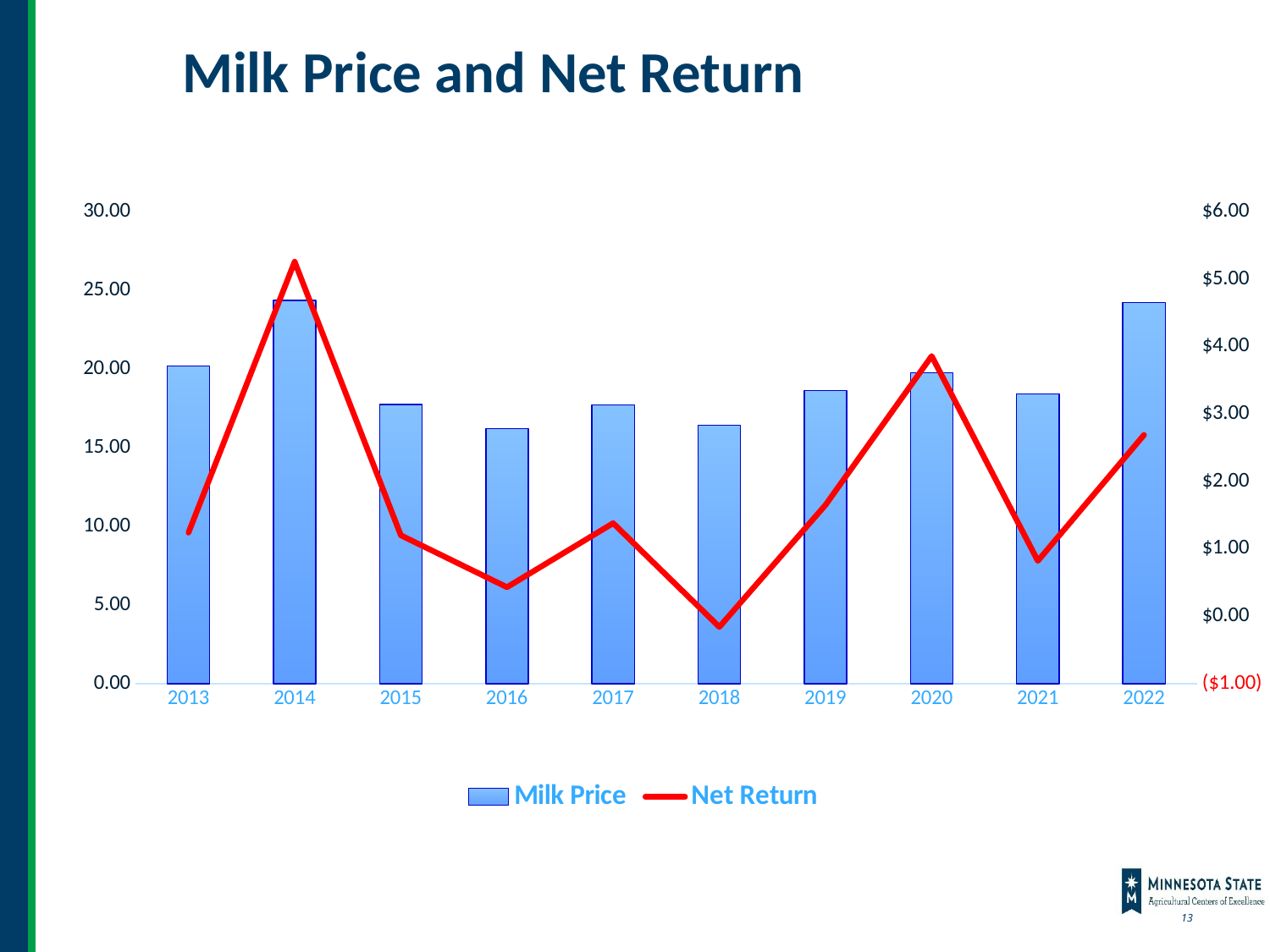
Which year has the lowest Net Return? 2018 What type of chart is shown on the slide? A combination bar and line chart Which year has the highest Net Return? 2014 Is the Net Return for 2020 greater or less than $3.00? greater Which year has the larger Net Return, 2020 or 2021? 2020 How many years are shown on the x axis of the chart? 10 Is the Net Return for 2018 greater or less than $0.00? less Which year has the larger Milk Price, 2014 or 2016? 2014 Is the Milk Price for 2016 greater or less than 20.00? less How many series does the legend list? 2 Does the Net Return rise or fall from 2020 to 2021? fall